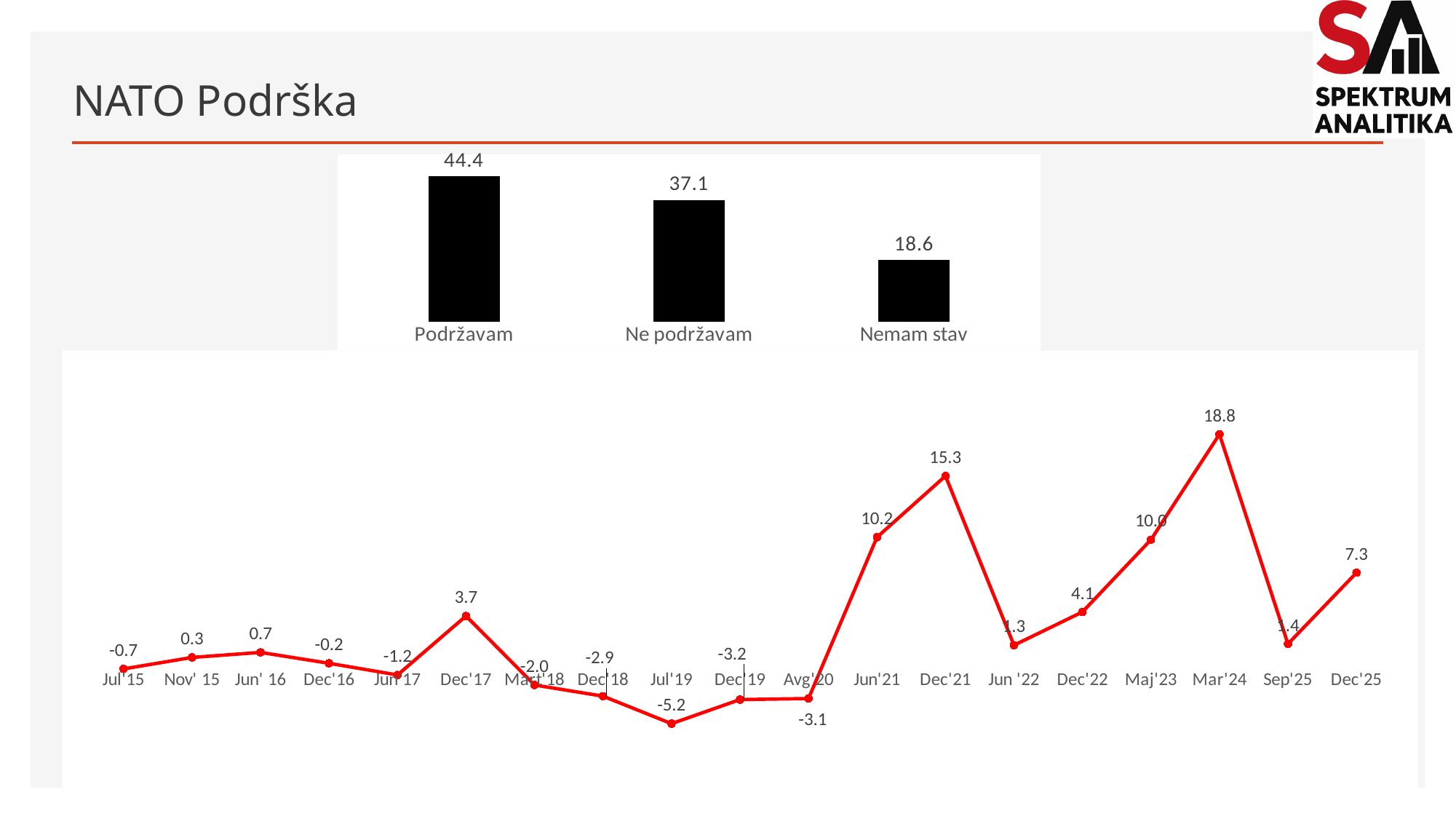
What kind of chart is the top chart on the slide? bar chart In the top bar chart, what is the value for Nemam stav? 18.6 In the top bar chart, what is the difference between Podržavam and Ne podržavam? 7.3 In the bottom line chart, what is the difference between the values for Dec'25 and Sep'25? 5.9 In the bottom line chart, what is the value for Mar'24? 18.8 How many categories does the top bar chart show? 3 How many data points does the bottom line chart show? 19 In the top bar chart, what is the value for Podržavam? 44.4 In the bottom line chart, what is the value for Jul'19? -5.2 In the top bar chart, which category has the lowest value? Nemam stav In the bottom line chart, which is larger, the value for Dec'21 or the value for Jun'21? Dec'21 In the bottom line chart, which point has the highest value? Mar'24